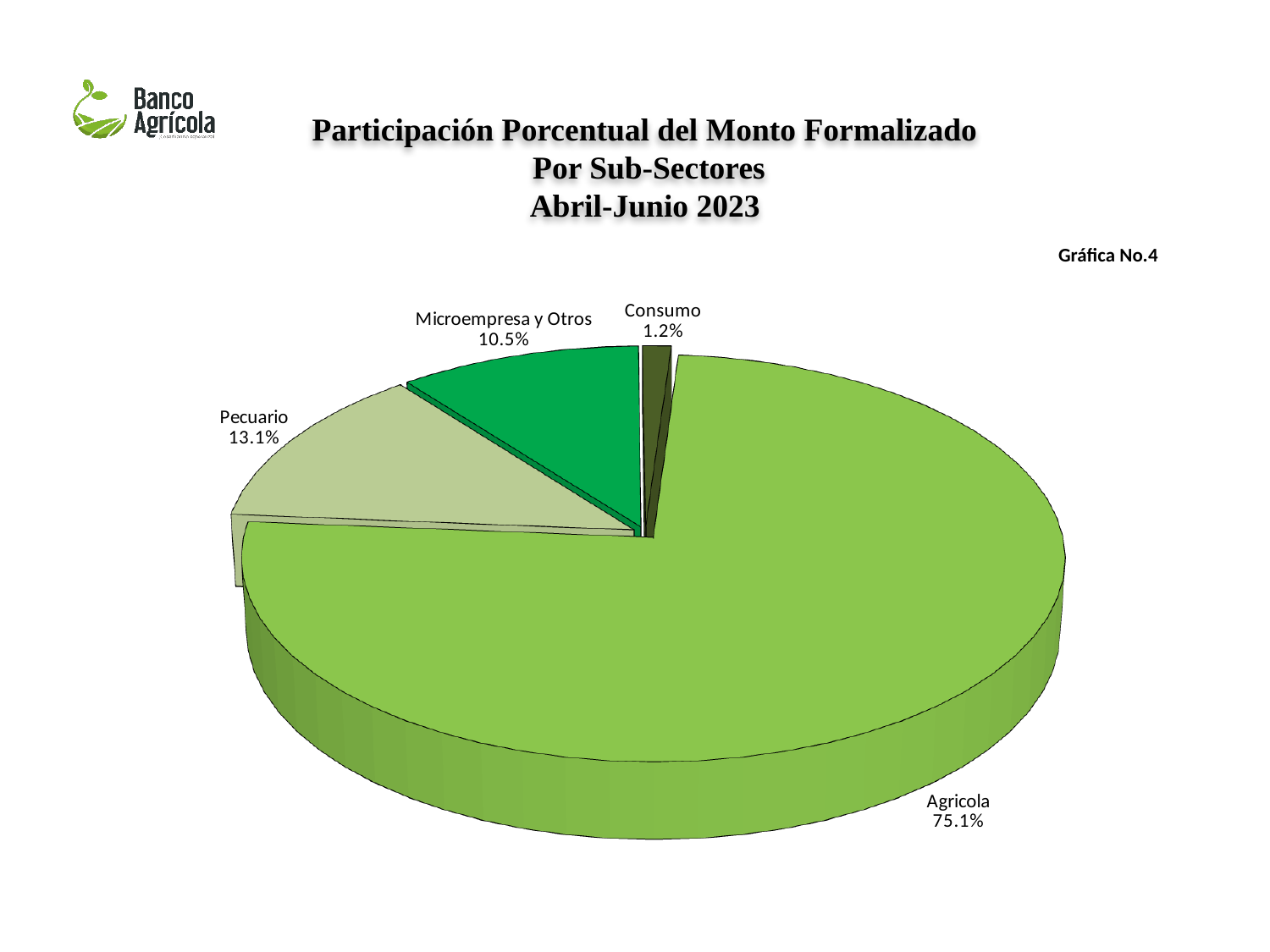
What share of the pie does Agricola represent? 75.1% How many sub-sectors are shown in the pie chart? 4 Which sub-sector has the largest share of the pie? Agricola What kind of chart is shown on the slide? Pie chart What is the difference in percentage points between Agricola and Pecuario? 62 What is the value shown for Pecuario? 13.1% What is the difference in percentage points between Pecuario and Microempresa y Otros? 2.6 What is the value shown for Microempresa y Otros? 10.5% What is the value shown for Consumo? 1.2% Which sub-sector has the smallest share of the pie? Consumo What period does the chart title say the data covers? Abril-Junio 2023 Which is larger, the share for Pecuario or the share for Microempresa y Otros? Pecuario